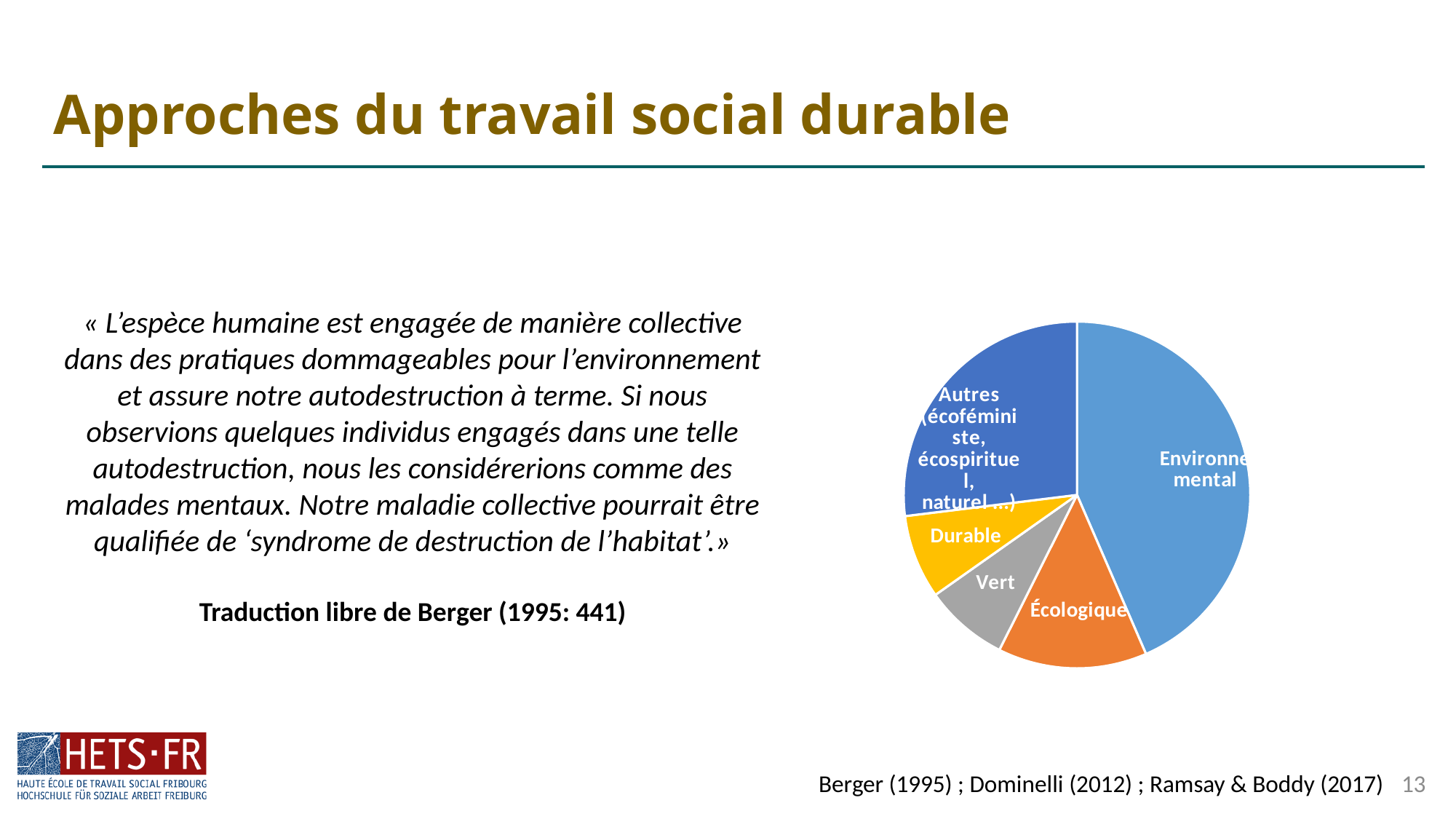
What colour is the Durable slice of the pie chart? yellow What colour is the Environnemental slice of the pie chart? light blue Which is larger in the pie chart, Autres (écoféministe, écospirituel, naturel...) or Écologique? Autres (écoféministe, écospirituel, naturel...) How many slices does the pie chart have? 5 Which slice of the pie chart is the largest? Environnemental Which is larger in the pie chart, Autres (écoféministe, écospirituel, naturel...) or Durable? Autres (écoféministe, écospirituel, naturel...) Which is larger in the pie chart, Écologique or Vert? Écologique What kind of chart is shown on the right of the slide? pie chart